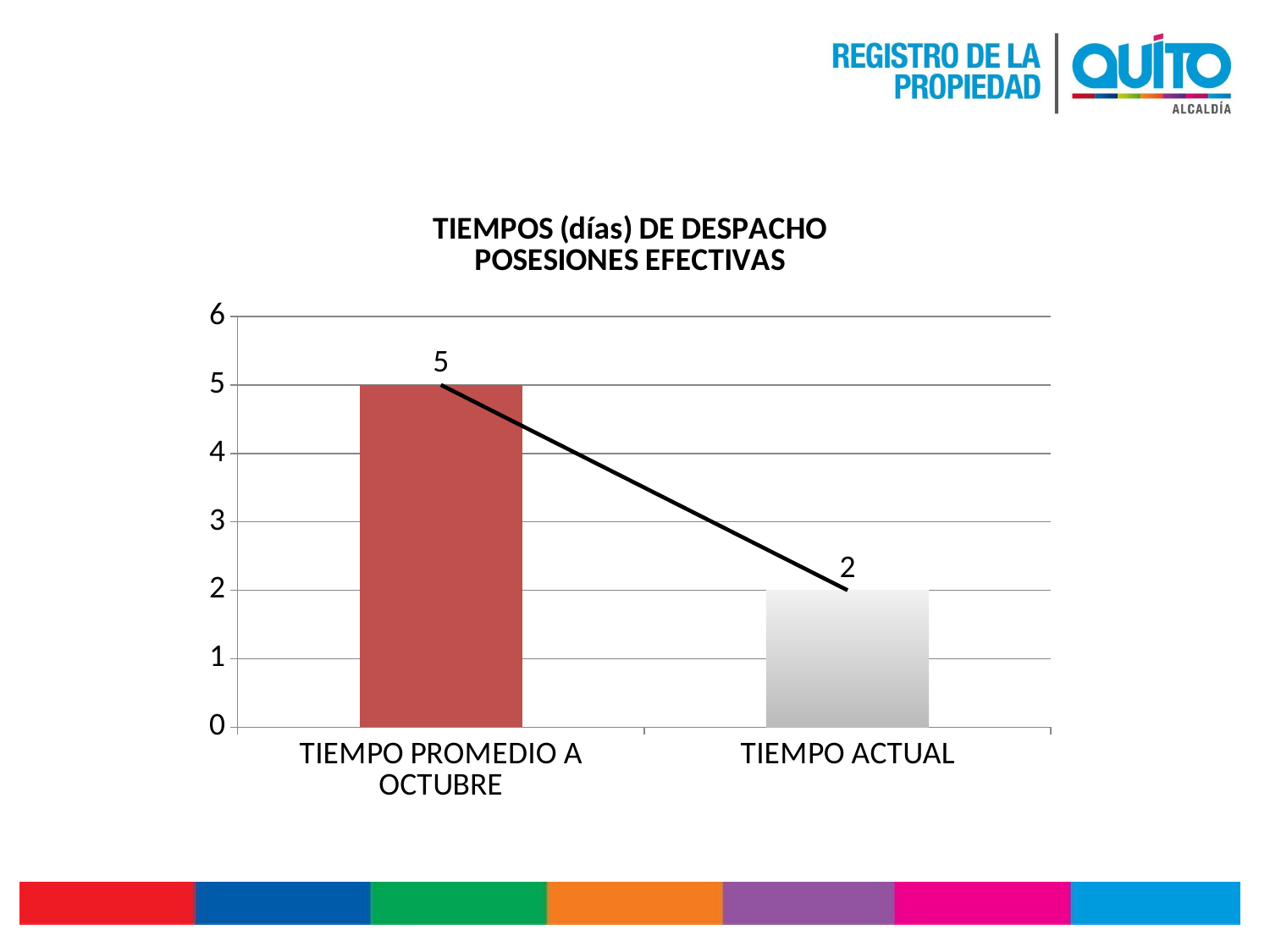
Which category has the lowest value? TIEMPO ACTUAL What is the value for TIEMPO ACTUAL? 2 What kind of chart is shown on the slide? bar chart What is the title of the chart? TIEMPOS (días) DE DESPACHO POSESIONES EFECTIVAS Is the value for TIEMPO ACTUAL greater or less than 3? less Do the values rise or fall from TIEMPO PROMEDIO A OCTUBRE to TIEMPO ACTUAL? fall What is the value for TIEMPO PROMEDIO A OCTUBRE? 5 What is the difference between the values for TIEMPO PROMEDIO A OCTUBRE and TIEMPO ACTUAL? 3 Which category has the highest value? TIEMPO PROMEDIO A OCTUBRE Is the value for TIEMPO PROMEDIO A OCTUBRE greater or less than 4? greater Which is larger, the value for TIEMPO PROMEDIO A OCTUBRE or the value for TIEMPO ACTUAL? TIEMPO PROMEDIO A OCTUBRE How many categories are shown on the chart? 2